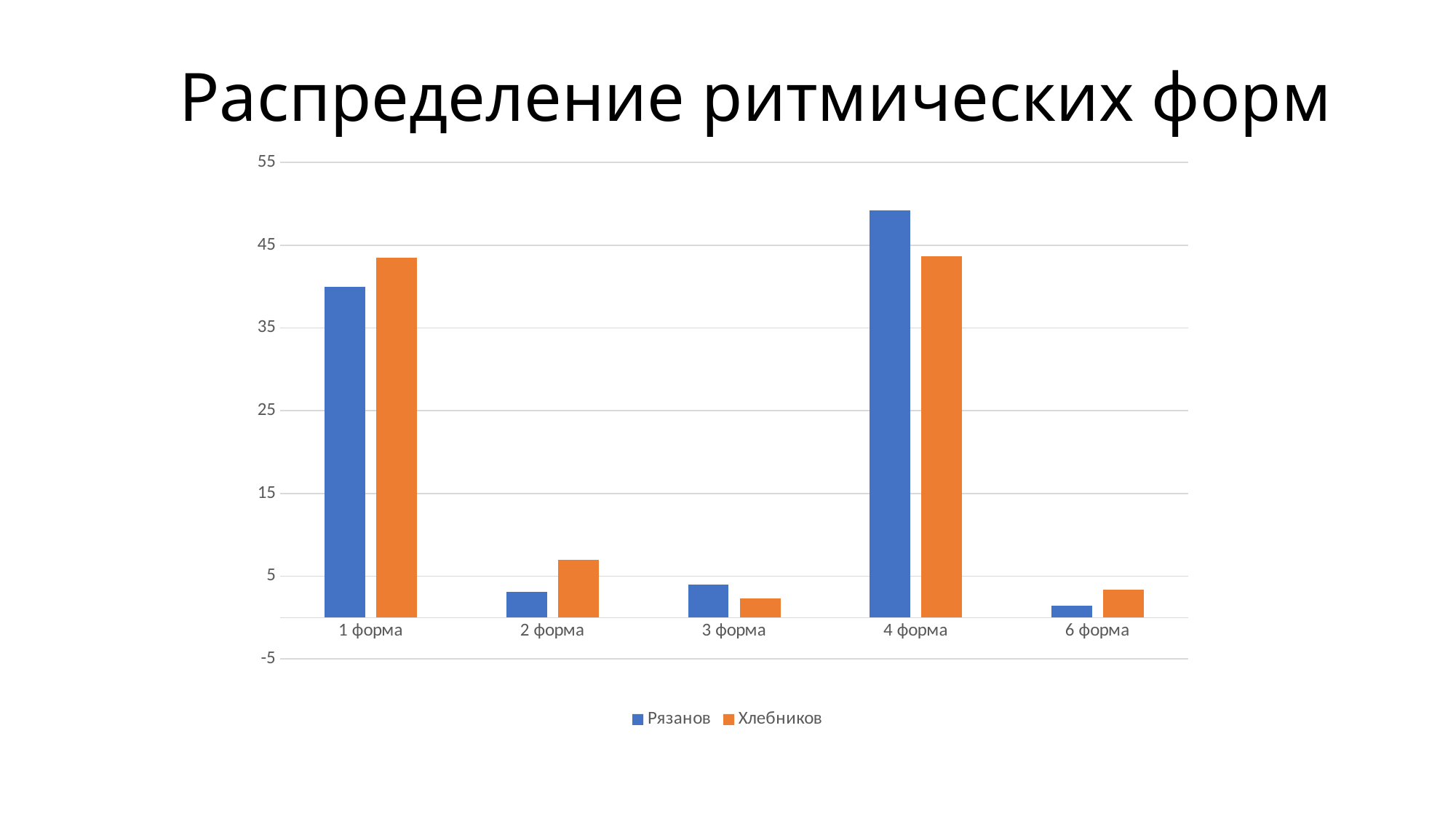
Is the value for Рязанов at 1 форма greater or less than 35? greater Is the value for Хлебников at 2 форма greater or less than 5? greater Which category has the highest value for Рязанов? 4 форма For 1 форма, which series has the larger value, Рязанов or Хлебников? Хлебников How many series does the legend list? 2 Is the value for Рязанов at 4 форма greater or less than 45? greater For 2 форма, which series has the larger value, Рязанов or Хлебников? Хлебников For 4 форма, which series has the larger value, Рязанов or Хлебников? Рязанов What is the title of the chart? Распределение ритмических форм What kind of chart is shown on the slide? bar chart How many categories are shown on the x axis? 5 Which category has the lowest value for Рязанов? 6 форма